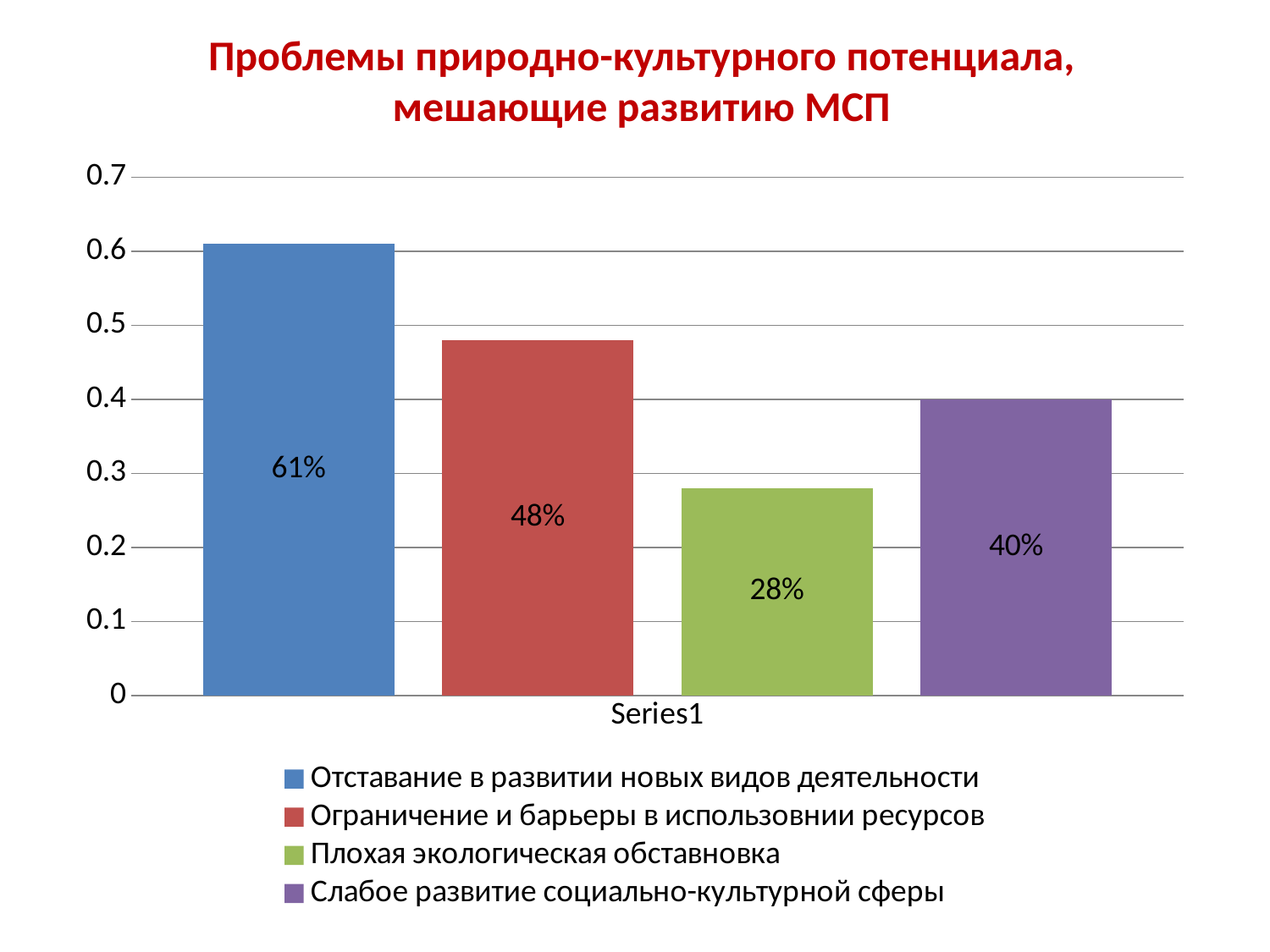
How many series does the legend list? 4 What is the title of the chart? Проблемы природно-культурного потенциала, мешающие развитию МСП What is the value for «Плохая экологическая обставновка»? 28% Which is larger: the value for «Слабое развитие социально-культурной сферы» or for «Плохая экологическая обставновка»? Слабое развитие социально-культурной сферы Which category has the lowest value? Плохая экологическая обставновка Which category has the highest value? Отставание в развитии новых видов деятельности What is the value for «Слабое развитие социально-культурной сферы»? 40% What colour is the bar for «Плохая экологическая обставновка»? Green What is the value for «Ограничение и барьеры в использовнии ресурсов»? 48% What is the difference between the values for «Отставание в развитии новых видов деятельности» and «Ограничение и барьеры в использовнии ресурсов»? 13% What is the value for «Отставание в развитии новых видов деятельности»? 61% What kind of chart is shown on the slide? Bar chart